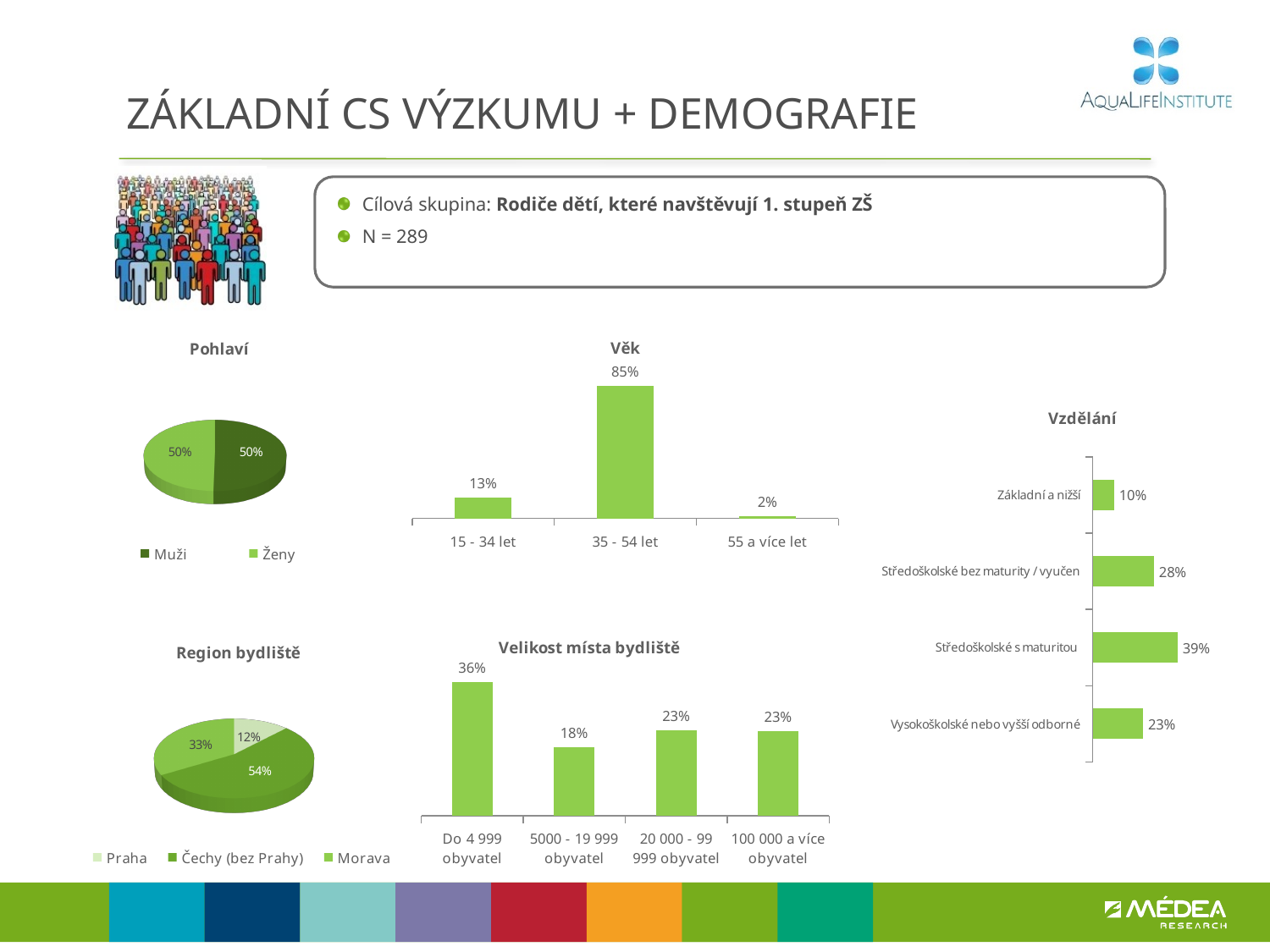
In the 'Vzdělání' chart, what is the value for 'Středoškolské s maturitou'? 39% In the 'Vzdělání' chart, which is larger: 'Středoškolské bez maturity / vyučen' or 'Vysokoškolské nebo vyšší odborné'? Středoškolské bez maturity / vyučen In the 'Věk' chart, which age category has the lowest value? 55 a více let In the 'Vzdělání' chart, which category has the highest value? Středoškolské s maturitou In the 'Pohlaví' chart, what is the value for 'Muži'? 50% In the 'Velikost místa bydliště' chart, which category has the highest value? Do 4 999 obyvatel What kind of chart is the 'Region bydliště' chart? Pie chart In the 'Vzdělání' chart, how many categories are shown? 4 In the 'Region bydliště' pie chart, what share does 'Čechy (bez Prahy)' have? 54% In the 'Věk' chart, what is the value for '35 - 54 let'? 85% In the 'Velikost místa bydliště' chart, what is the value for '5000 - 19 999 obyvatel'? 18% In the 'Věk' chart, what is the difference between the values for '35 - 54 let' and '15 - 34 let'? 72%